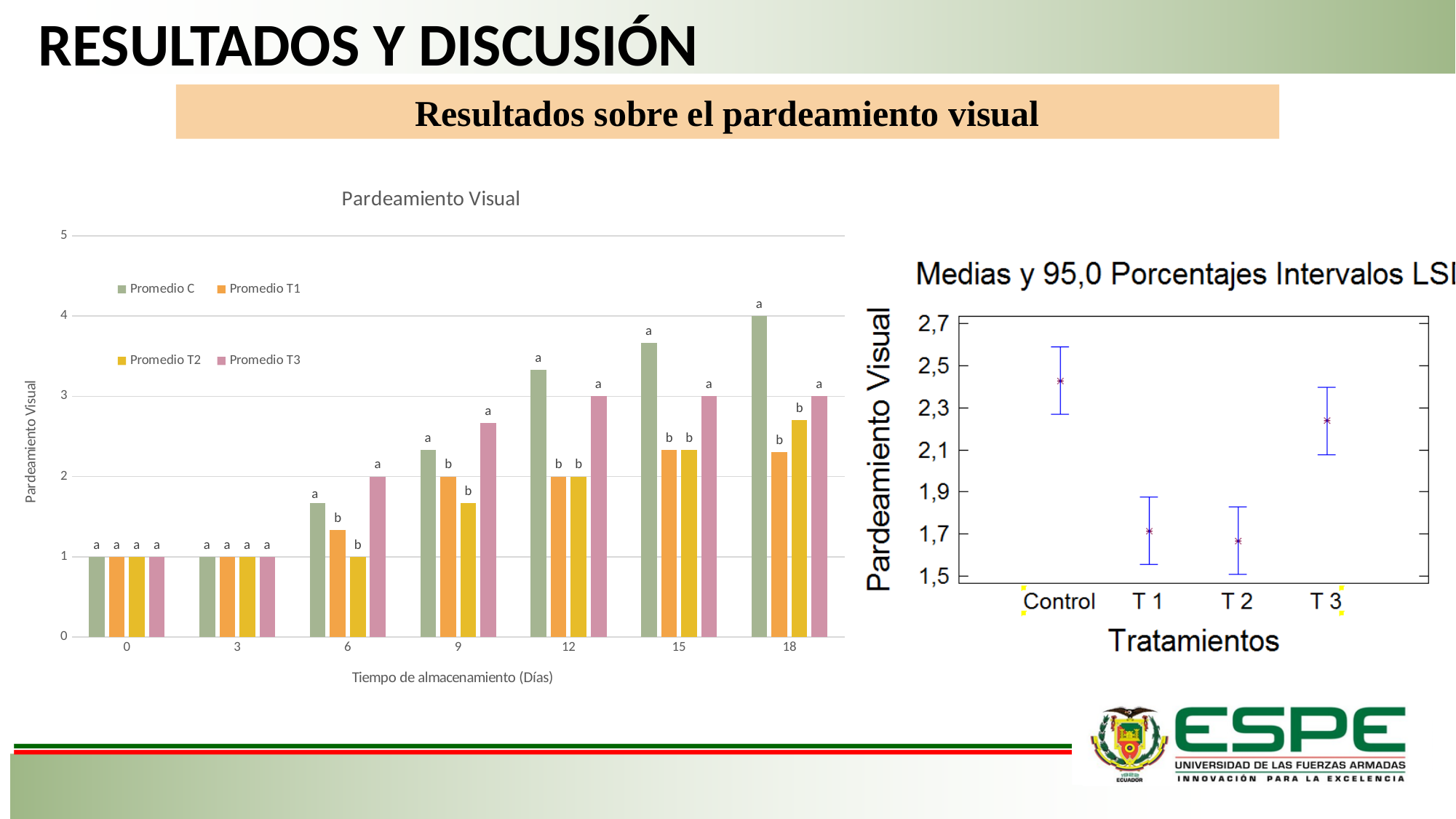
In the bar chart titled 'Pardeamiento Visual', at which storage time does Promedio C reach its highest value? 18 In the bar chart titled 'Pardeamiento Visual', how many series does the legend list? 4 What kind of chart is the chart titled 'Pardeamiento Visual'? Bar chart In the bar chart titled 'Pardeamiento Visual', does Promedio C rise or fall as storage time increases from day 0 to day 18? Rises In the chart on the right ('Medias y 95,0 Porcentajes Intervalos LSD'), which treatment has the highest mean Pardeamiento Visual? Control In the bar chart titled 'Pardeamiento Visual', is the value for Promedio T1 at day 6 greater or less than 2? less In the bar chart titled 'Pardeamiento Visual', which is larger at day 9: Promedio C or Promedio T2? Promedio C In the bar chart titled 'Pardeamiento Visual', is the value for Promedio C at day 15 greater or less than 3? greater In the bar chart titled 'Pardeamiento Visual', what is the value of Promedio C at day 18? 4 In the bar chart titled 'Pardeamiento Visual', what is the value of Promedio T1 at day 0? 1 In the bar chart titled 'Pardeamiento Visual', what is the value of Promedio T3 at day 12? 3 In the bar chart titled 'Pardeamiento Visual', how many storage-time categories are shown on the x axis? 7